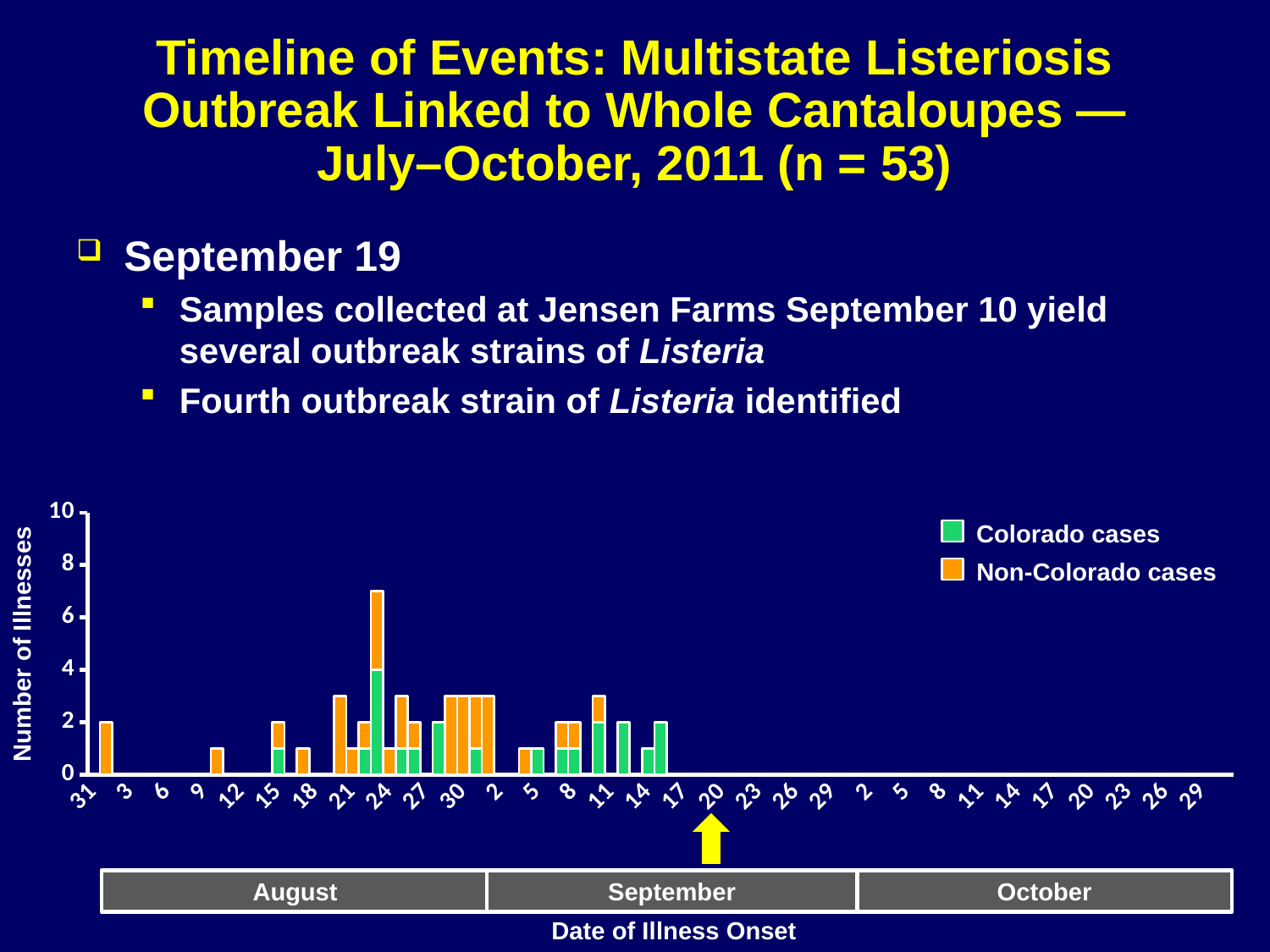
Which has more illnesses, August 24 or September 11? August 24 What kind of chart is shown on the slide? bar chart Is the number of illnesses for August 30 greater or less than 4? less How many series does the chart legend list? 2 On which date of illness onset is the number of illnesses highest? August 23 What is the total number of illnesses with onset on August 15? 2 Is the number of illnesses for August 24 greater or less than 6? less Do the number of illnesses rise or fall from mid-September into October? fall Is the number of illnesses for August 24 greater or less than 8? less How many months are labeled along the x axis? 3 What are the two series named in the chart legend? Colorado cases and Non-Colorado cases